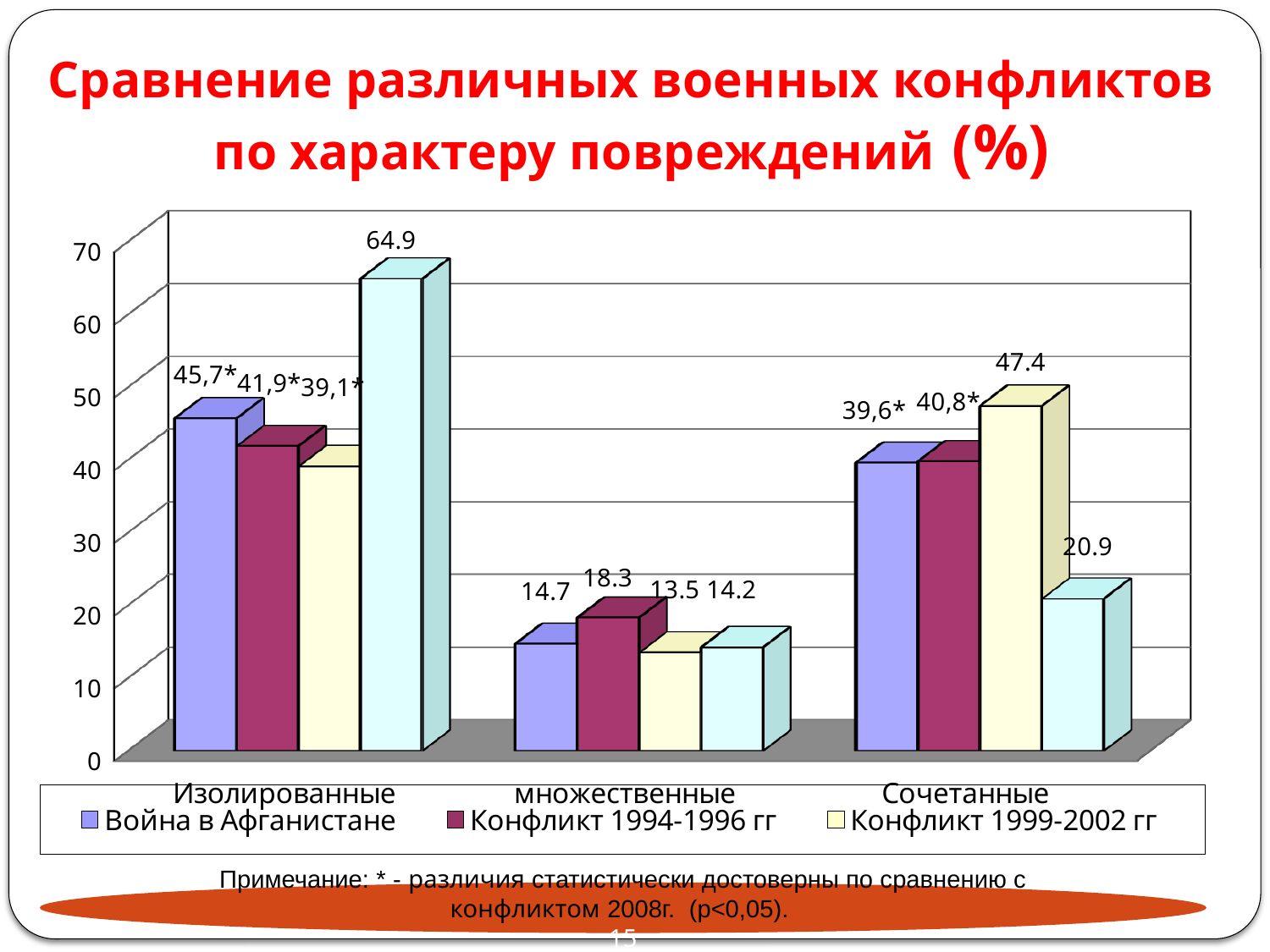
In the Изолированные category, which is larger: Война в Афганистане or Конфликт 1999-2002 гг? Война в Афганистане What is the title of the slide? Сравнение различных военных конфликтов по характеру повреждений (%) What is the value for Конфликт 1999-2002 гг in the Сочетанные category? 47.4 How many categories are shown on the x axis? 3 In the множественные category, which of the legend series has the highest value? Конфликт 1994-1996 гг What kind of chart is shown on the slide? bar chart Is the value for Конфликт 1994-1996 гг in the Изолированные category greater or less than 40? greater In the Сочетанные category, which of the legend series has the lowest value? Война в Афганистане What is the value for Война в Афганистане in the множественные category? 14.7 What is the value for Конфликт 1994-1996 гг in the множественные category? 18.3 How many series does the legend list? 3 For Конфликт 1999-2002 гг, what is the difference between the Сочетанные value and the множественные value? 33.9